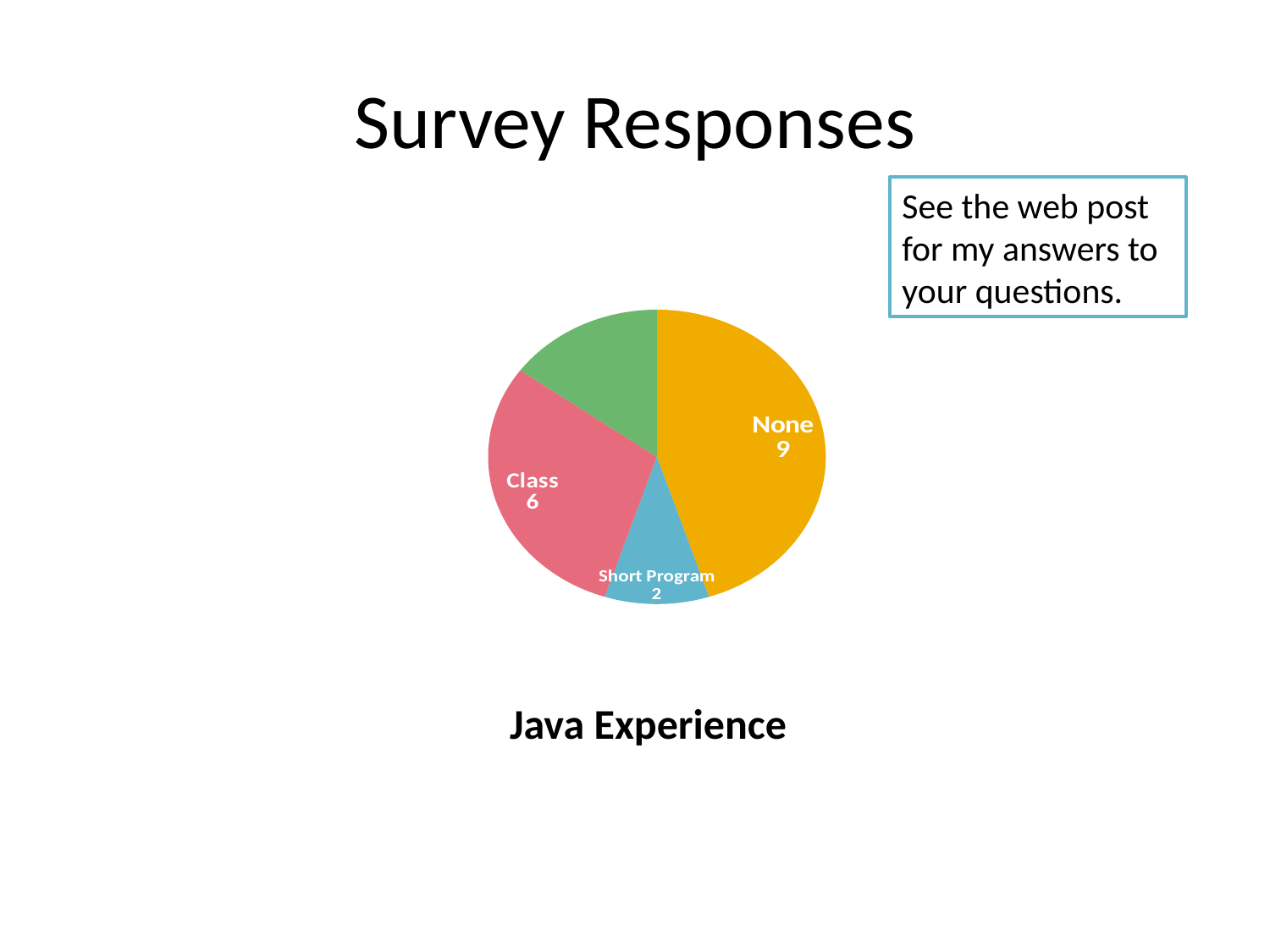
Which category has the smallest slice? Short Program What colour is the None slice? yellow What is the value for the None slice? 9 Which labelled category has the largest slice? None What is the difference between the Class and Short Program values? 4 What is the title shown below the pie chart? Java Experience Which is larger, the None slice or the Class slice? None What is the value for the Short Program slice? 2 How many slices does the pie chart have? 4 What is the value for the Class slice? 6 What is the difference between the None and Class values? 3 What kind of chart is shown on the slide? pie chart